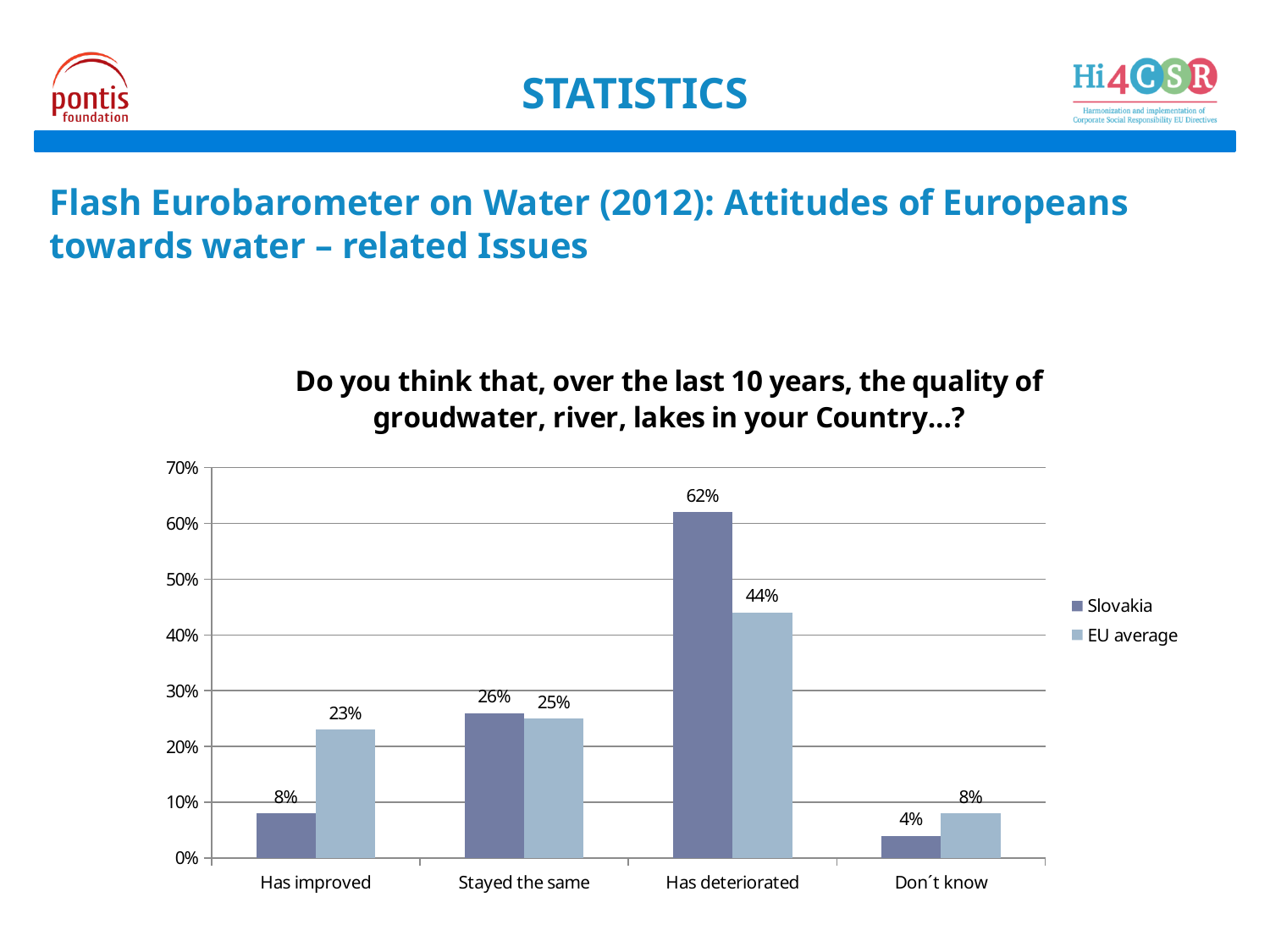
What is the value for Slovakia in the "Don´t know" category? 4% How many series does the legend list? 2 What is the EU average value for "Has improved"? 23% Which category has the highest value for Slovakia? Has deteriorated What kind of chart is shown on the slide? Bar chart What are the two series named in the legend? Slovakia and EU average What is the value for Slovakia in the "Has deteriorated" category? 62% Which is larger for "Stayed the same": Slovakia or EU average? Slovakia How many categories are shown on the x axis? 4 What is the difference between the Slovakia and EU average values for "Has deteriorated"? 18% What is the difference between the EU average and Slovakia values for "Has improved"? 15% Which category has the lowest value for the EU average? Don´t know